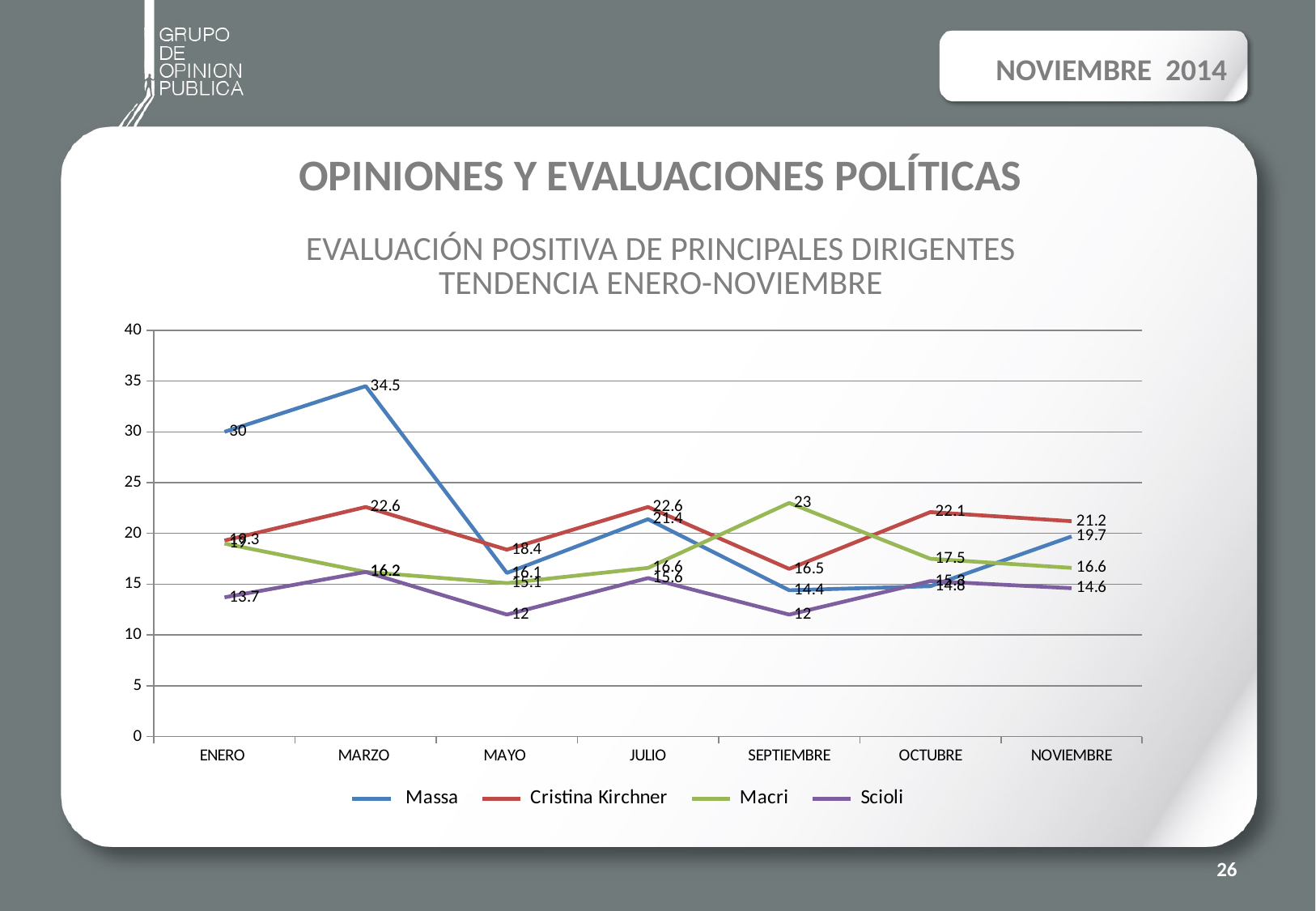
Is the value for Massa in ENERO greater or less than 25? greater Which is larger in NOVIEMBRE, Cristina Kirchner or Massa? Cristina Kirchner What is the value for Cristina Kirchner in MAYO? 18.4 How many months are shown on the x axis? 7 What is the value for Macri in SEPTIEMBRE? 23 What is the value for Massa in MARZO? 34.5 In which month does Scioli have its lowest value, 12? MAYO and SEPTIEMBRE In which month does Massa reach its highest value? MARZO How many series does the legend list? 4 What kind of chart is shown on the slide? Line chart What is the value for Scioli in NOVIEMBRE? 14.6 What is the difference between Massa's value in MARZO and in MAYO? 18.4